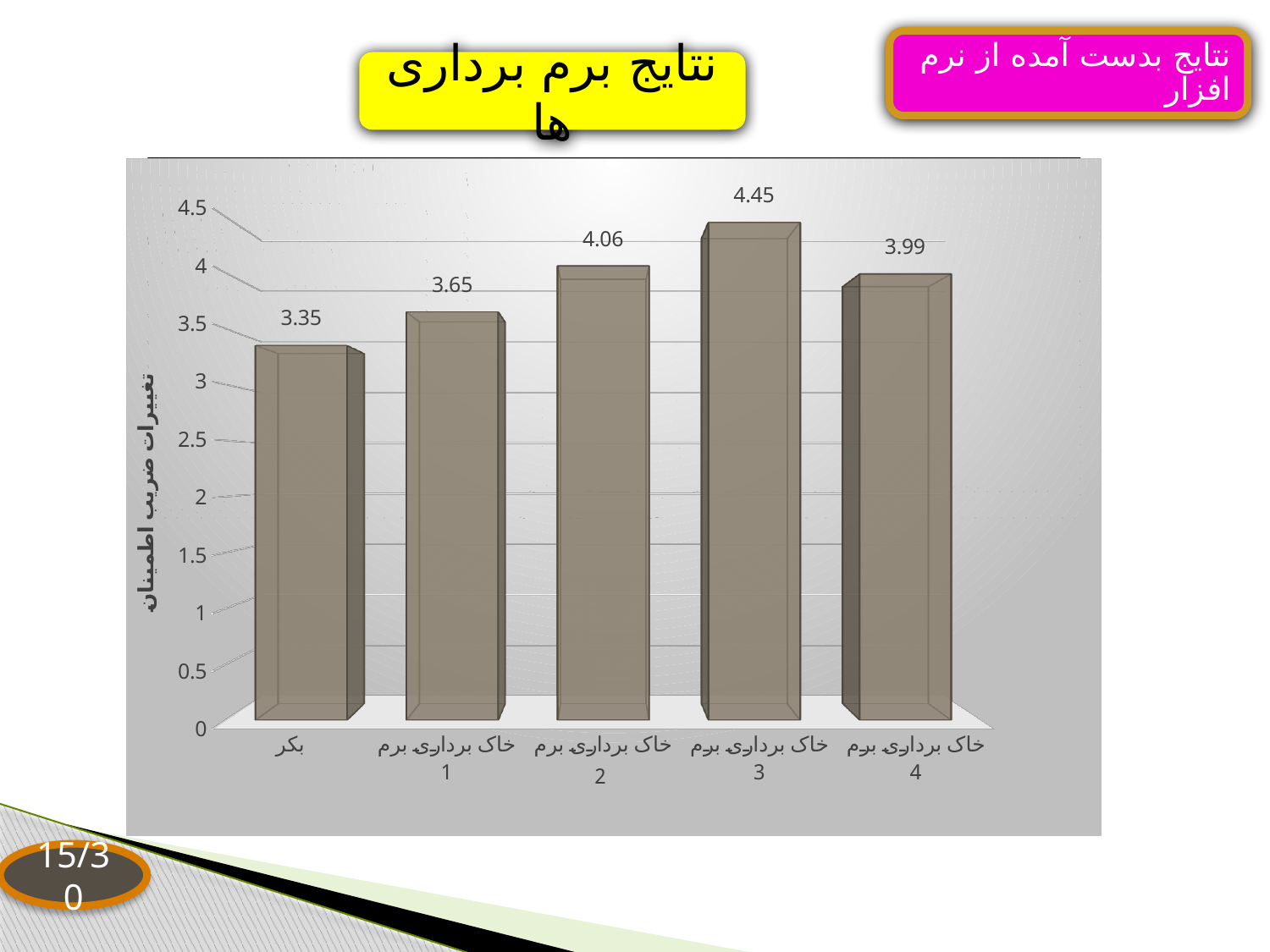
What is the value for بکر? 3.35 What is the value for خاک برداری برم 3? 4.45 What is the label of the vertical axis? تغییرات ضریب اطمینان Is the value for خاک برداری برم 1 greater or less than 4? less Which is larger, the value for خاک برداری برم 2 or خاک برداری برم 4? خاک برداری برم 2 Which category has the highest value? خاک برداری برم 3 What is the value for خاک برداری برم 4? 3.99 Which category has the lowest value? بکر What is the difference between the values for خاک برداری برم 3 and بکر? 1.10 What kind of chart is shown on the slide? bar chart What is the difference between the values for خاک برداری برم 2 and خاک برداری برم 1? 0.41 How many categories are shown on the x axis? 5